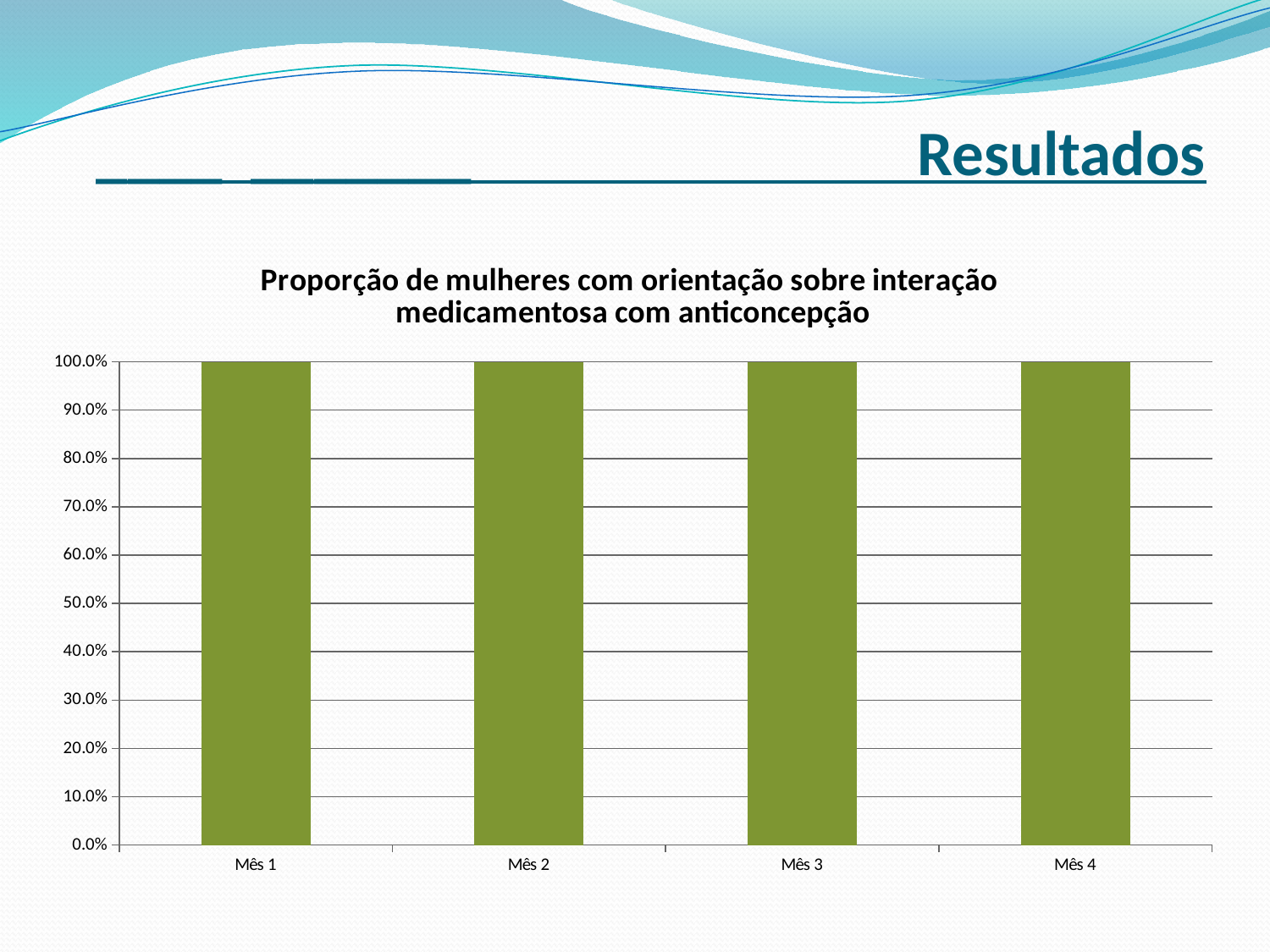
How many categories are plotted on the x axis of the chart? 4 What is the value for Mês 1? 100.0% Do the values rise, fall, or stay the same from Mês 1 to Mês 4? stay the same What is the title of the chart? Proporção de mulheres com orientação sobre interação medicamentosa com anticoncepção What kind of chart is shown on the slide? bar chart What is the value for Mês 4? 100.0% Is the value for Mês 3 greater or less than 90.0%? greater What colour are the bars in the chart? green What is the difference between the values for Mês 1 and Mês 4? 0.0% Is the value for Mês 1 greater or less than 50.0%? greater What is the value for Mês 3? 100.0% What is the value for Mês 2? 100.0%